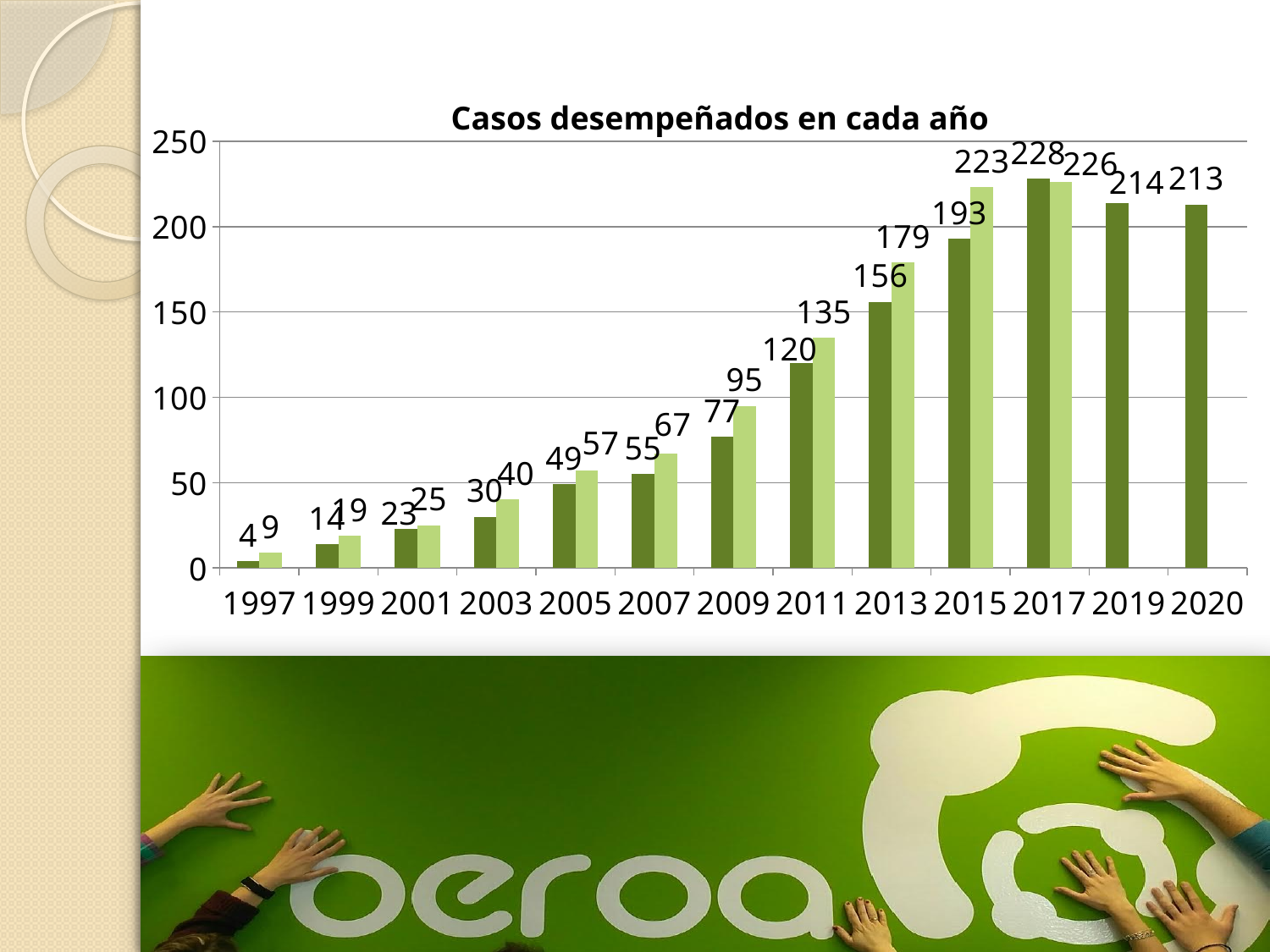
What is the title of the chart? Casos desempeñados en cada año What is the highest value labeled on the chart? 228 What is the difference between the value for 2019 and the value for 2020? 1 What is the lowest value labeled on the chart? 4 How many year labels are shown on the x axis? 13 What is the value shown for 2019? 214 What type of chart is shown on the slide? bar chart What is the value of the light green bar at 2015? 223 What is the value of the dark green bar at 2011? 120 Which is larger, the dark green bar at 2013 or the dark green bar at 2015? 2015 What is the value of the dark green bar at 1997? 4 What is the value shown for 2020? 213